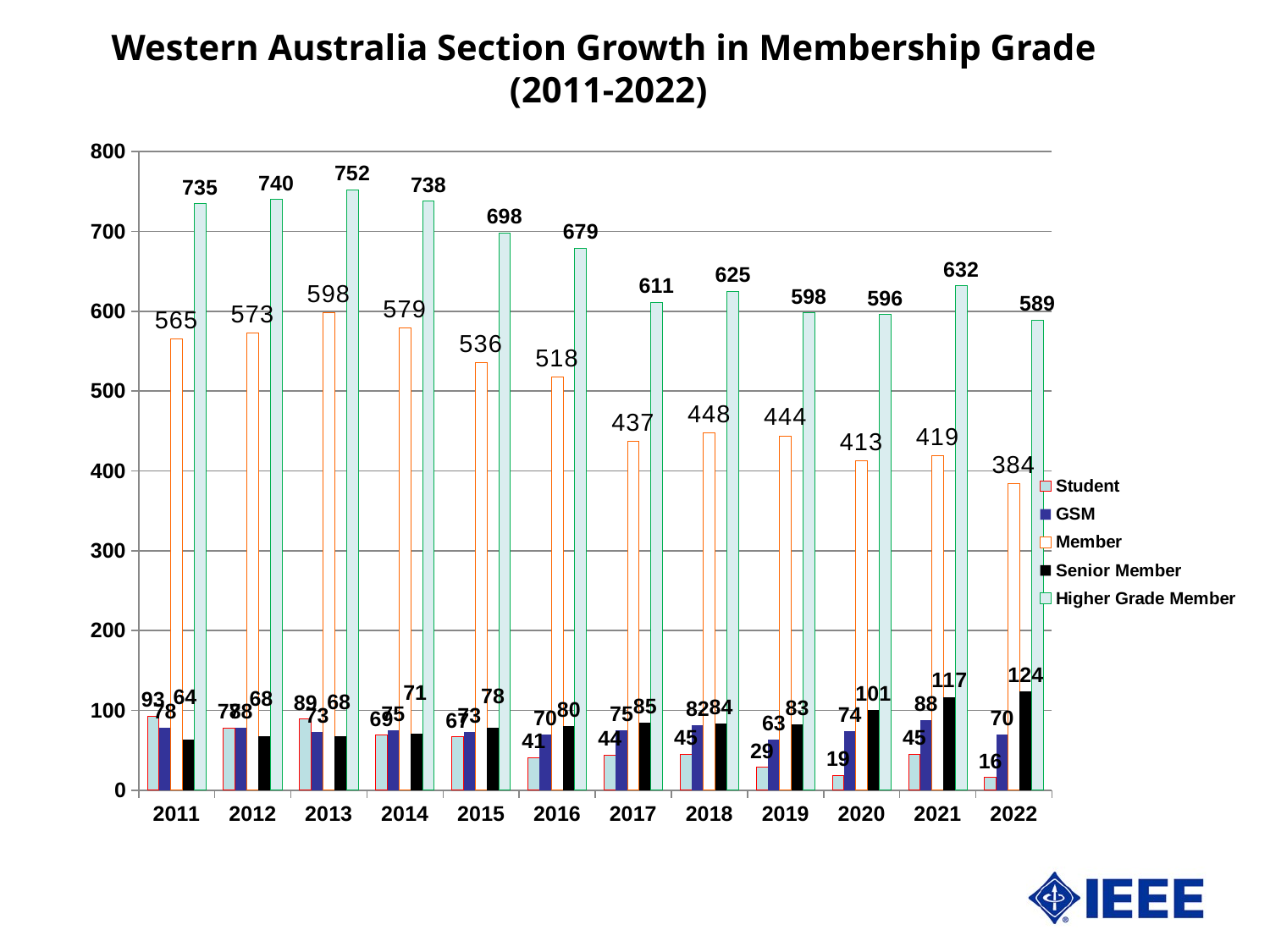
What is the Member value for 2011? 565 In which year is the Member value lowest? 2022 Which year has the larger Member value, 2013 or 2014? 2013 What kind of chart is shown on the slide? bar chart What is the Senior Member value for 2022? 124 In which year is the Higher Grade Member value highest? 2013 What is the Student value for 2020? 19 How many series does the legend list? 5 What is the difference between the Higher Grade Member values for 2011 and 2022? 146 How many years are shown on the x axis? 12 What is the Higher Grade Member value for 2013? 752 Is the Member value for 2017 greater or less than 500? less